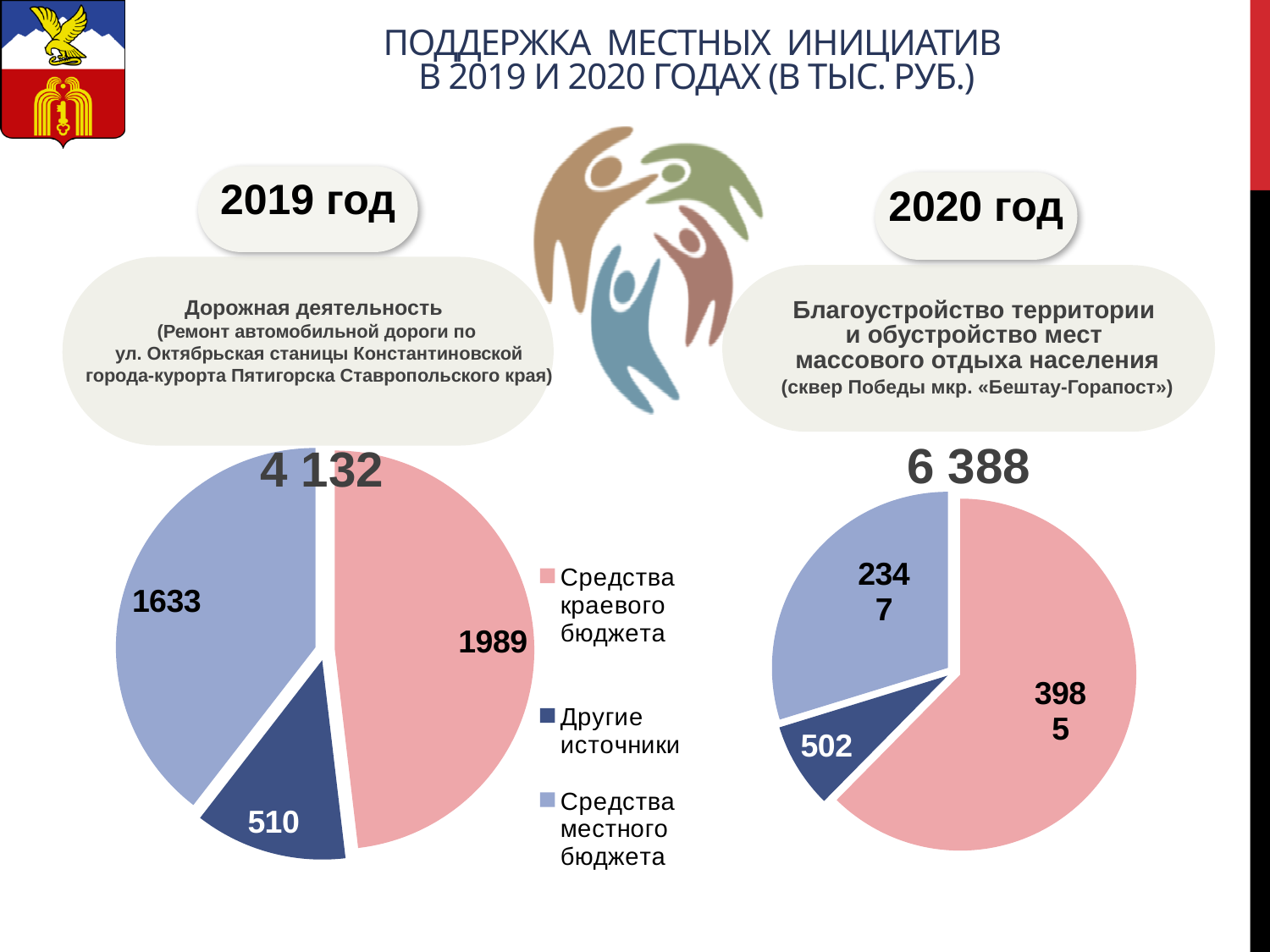
What total is printed above the 2020 год pie chart? 6 388 In the 2019 год pie chart, which category has the largest value? Средства краевого бюджета In the 2020 год pie chart, what is the value for Другие источники? 502 In the 2019 год pie chart, what is the value for Средства краевого бюджета? 1989 In the 2019 год pie chart, what is the value for Средства местного бюджета? 1633 How many categories does the legend list for the pie charts? 3 In the 2019 год pie chart, what is the difference between Средства краевого бюджета and Средства местного бюджета? 356 In the 2019 год pie chart, which category has the smallest value? Другие источники What type of chart is used for the 2019 год data? pie chart What total is printed above the 2019 год pie chart? 4 132 In the 2020 год pie chart, which category has the largest slice? Средства краевого бюджета In the 2019 год pie chart, what is the value for Другие источники? 510